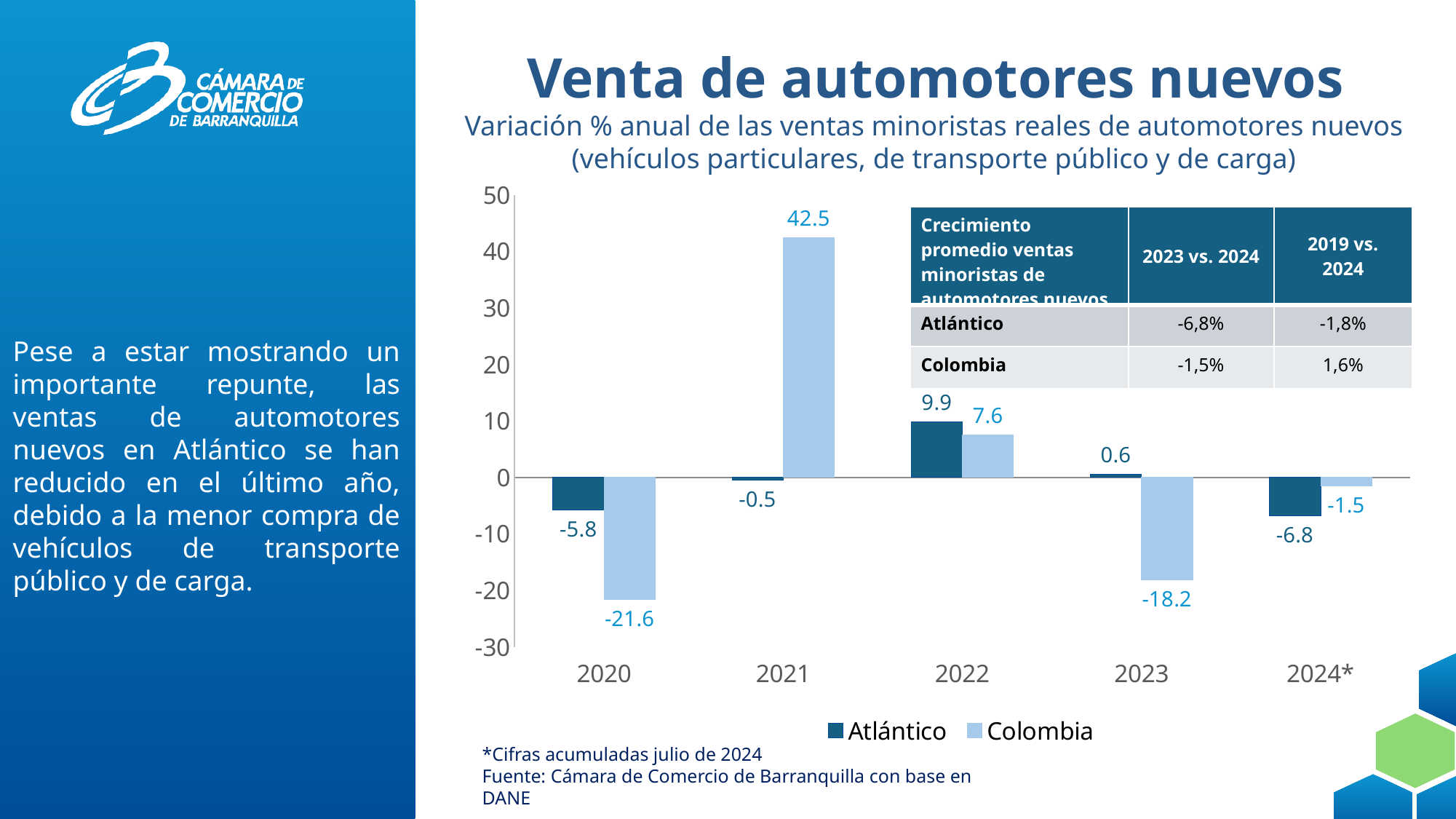
In which year is the Colombia value lowest? 2020 In which year is the Atlántico value lowest? 2024* What is the value for Atlántico in 2024*? -6.8 How many series does the legend list? 2 What kind of chart is shown on the slide? Bar chart What is the value for Colombia in 2023? -18.2 What is the value for Colombia in 2021? 42.5 Which is larger in 2023, the Atlántico value or the Colombia value? Atlántico What is the value for Atlántico in 2022? 9.9 In which year is the Colombia value highest? 2021 How many years are shown on the x axis? 5 What is the difference between the Atlántico and Colombia values in 2022? 2.3